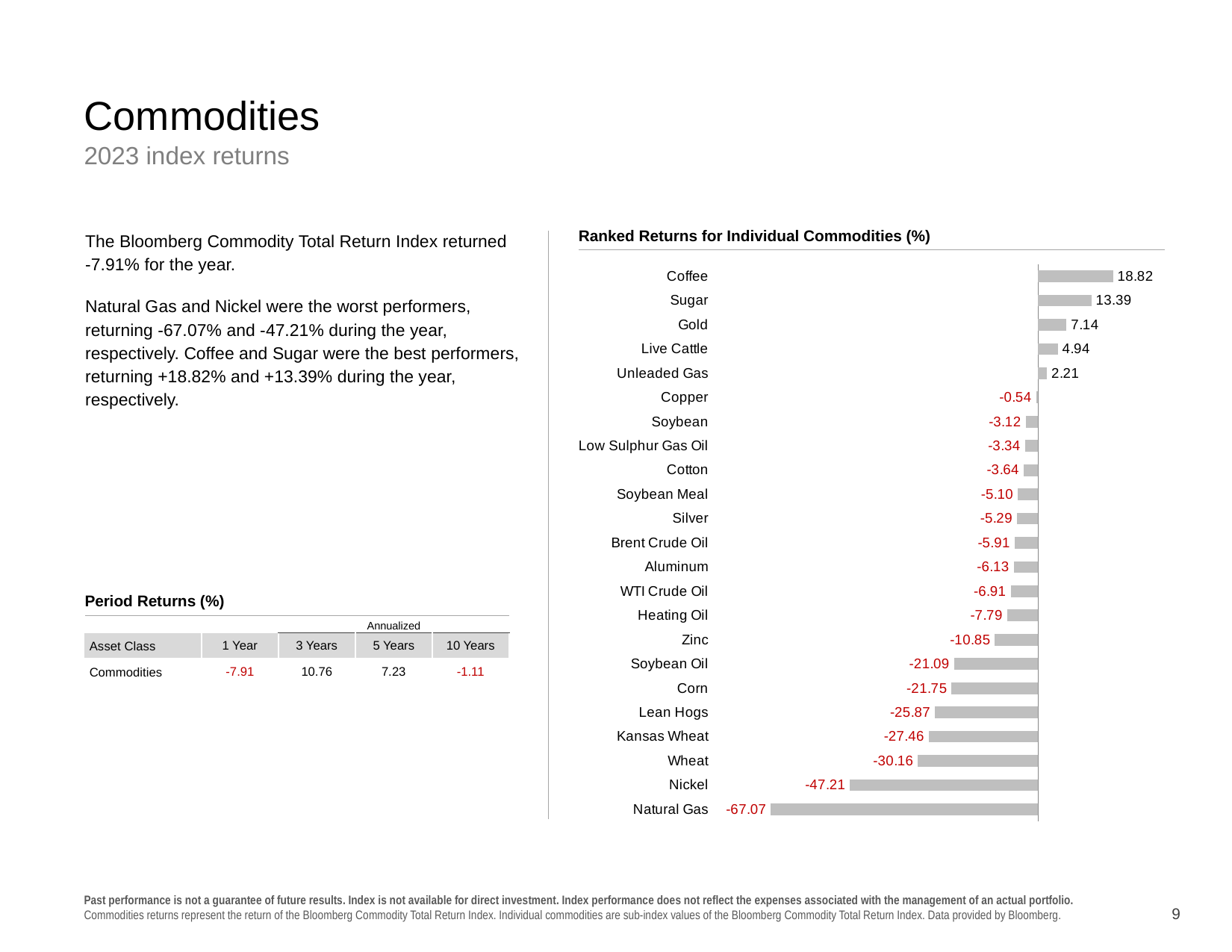
Which commodity has the lowest return in the Ranked Returns for Individual Commodities chart? Natural Gas Which commodity has the highest return in the Ranked Returns for Individual Commodities chart? Coffee What is the value for Gold in the Ranked Returns for Individual Commodities chart? 7.14 Which has the larger value in the Ranked Returns for Individual Commodities chart, Live Cattle or Unleaded Gas? Live Cattle What is the difference between the values for Nickel and Natural Gas in the Ranked Returns for Individual Commodities chart? 19.86 What kind of chart is the Ranked Returns for Individual Commodities chart? Bar chart What is the difference between the values for Coffee and Sugar in the Ranked Returns for Individual Commodities chart? 5.43 How many commodities are shown in the Ranked Returns for Individual Commodities chart? 23 What is the value for Natural Gas in the Ranked Returns for Individual Commodities chart? -67.07 What is the value for Zinc in the Ranked Returns for Individual Commodities chart? -10.85 Which has the larger value in the Ranked Returns for Individual Commodities chart, Corn or Wheat? Corn What is the value for Coffee in the Ranked Returns for Individual Commodities chart? 18.82